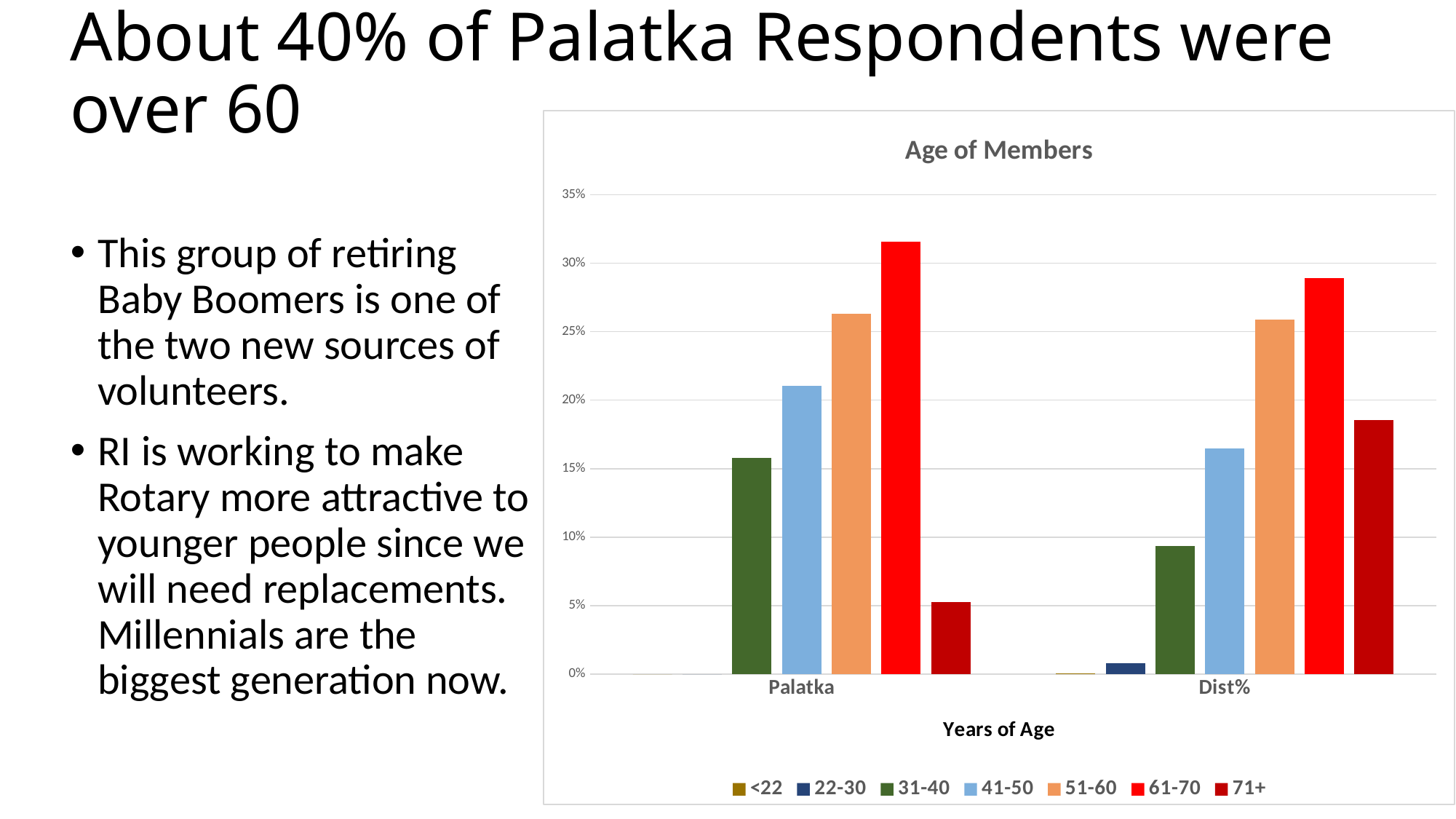
Is the value for the 61-70 group in Palatka greater or less than 30%? greater What is the title of the chart? Age of Members Which age group has the highest value for Dist%? 61-70 Which age group has the highest value for Palatka? 61-70 How many categories are shown on the x axis of the chart? 2 Which is larger: the 71+ value for Palatka or the 71+ value for Dist%? Dist% What kind of chart is shown on the slide? bar chart How many series does the chart legend list? 7 Is the value for the 71+ group in Palatka greater or less than 10%? less What is the label of the x axis of the chart? Years of Age Which is larger: the 41-50 value for Palatka or the 41-50 value for Dist%? Palatka Is the value for the 31-40 group in Dist% greater or less than 10%? less